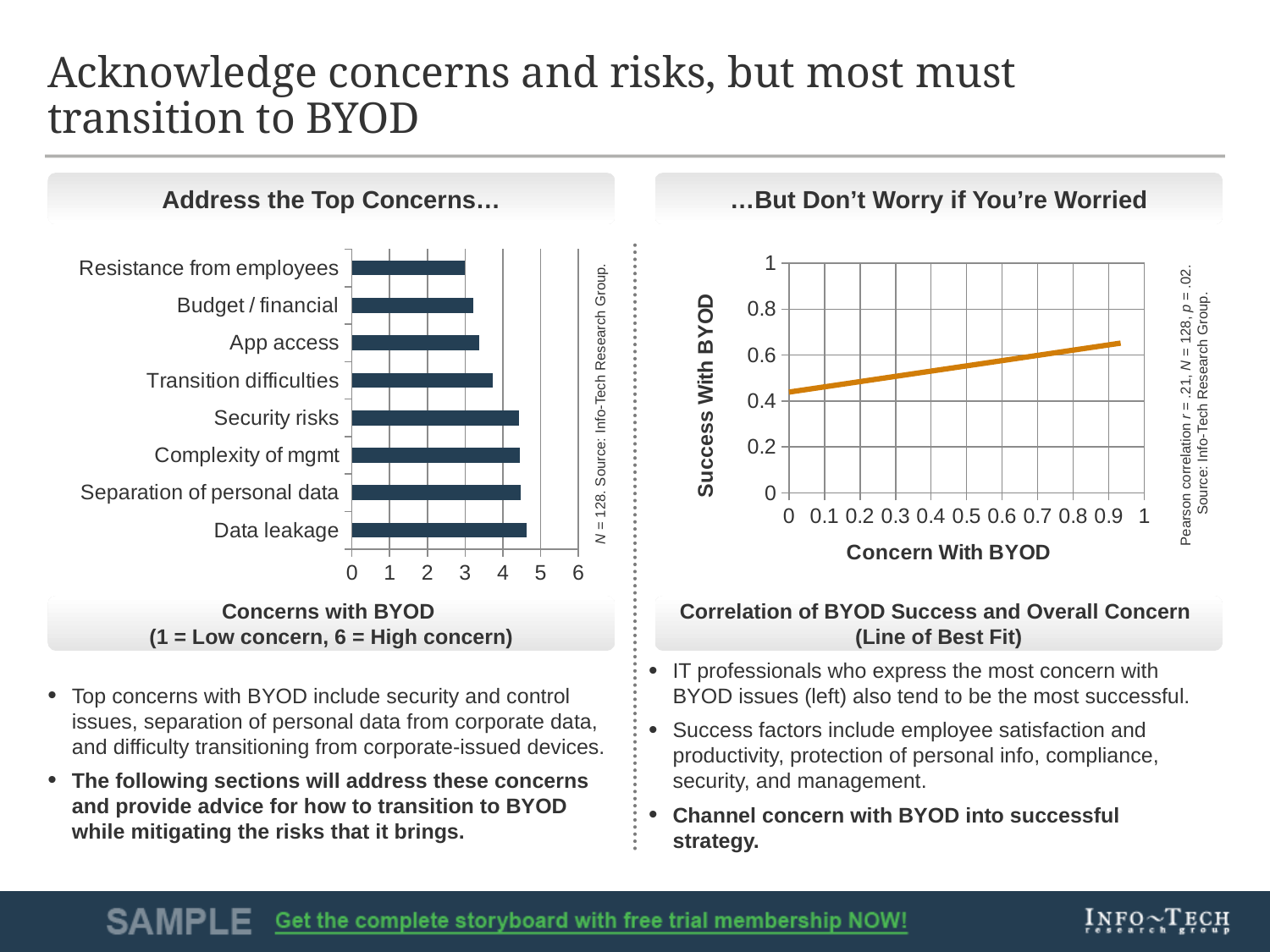
In the 'Concerns with BYOD' chart on the left, is the value for Transition difficulties greater or less than 4? less In the 'Concerns with BYOD' chart on the left, which is larger: Security risks or Budget / financial? Security risks In the 'Correlation of BYOD Success and Overall Concern' chart on the right, is the Success With BYOD value at Concern With BYOD = 0 greater or less than 0.6? less In the 'Concerns with BYOD' chart on the left, is the value for Data leakage greater or less than 4? greater In the 'Concerns with BYOD' chart on the left, how many concern categories are plotted? 8 What is the label of the x axis on the 'Correlation of BYOD Success and Overall Concern' chart on the right? Concern With BYOD What kind of chart is the 'Concerns with BYOD' chart on the left? bar chart What kind of chart is the 'Correlation of BYOD Success and Overall Concern' chart on the right? line chart In the 'Correlation of BYOD Success and Overall Concern' chart on the right, does the line rise or fall as Concern With BYOD increases? rises In the 'Concerns with BYOD' chart on the left, which concern has the highest value? Data leakage In the 'Concerns with BYOD' chart on the left, which concern has the lowest value? Resistance from employees